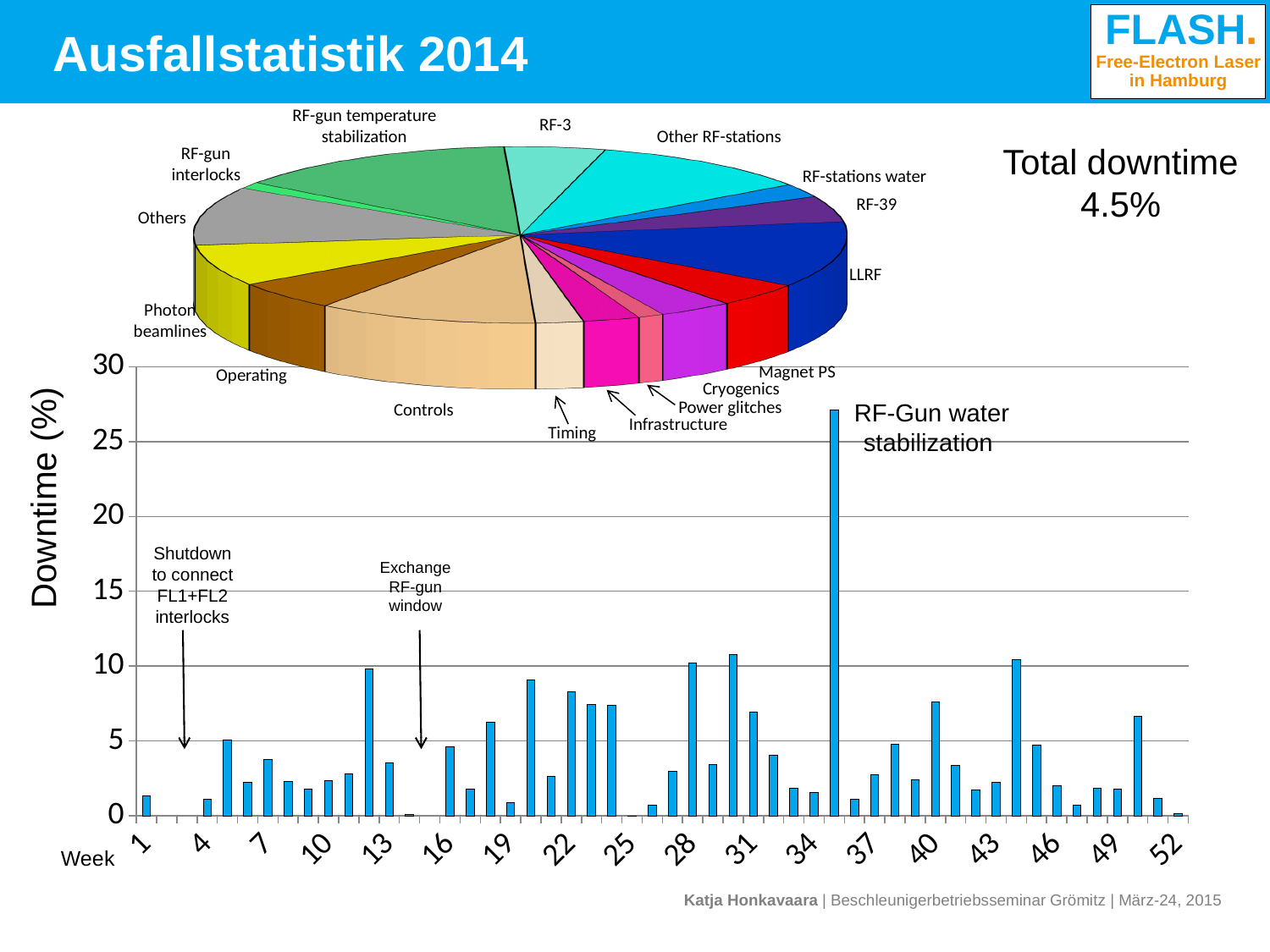
In the lower bar chart, which week has the highest downtime? Week 35 What kind of chart is the upper chart on the slide? pie chart In the lower bar chart, is the downtime for week 1 greater or less than 5? less In the lower bar chart, which has the larger downtime, week 12 or week 13? Week 12 In the lower bar chart, what is the label of the y axis? Downtime (%) In the lower bar chart, is the downtime for week 36 greater or less than 25? less In the upper pie chart, which slice is larger, LLRF or Cryogenics? LLRF What kind of chart is the lower chart on the slide? bar chart In the lower bar chart, is the downtime for week 20 greater or less than 10? less According to the text next to the upper pie chart, what is the total downtime? 4.5% In the upper pie chart, which slice is larger, Operating or Timing? Operating